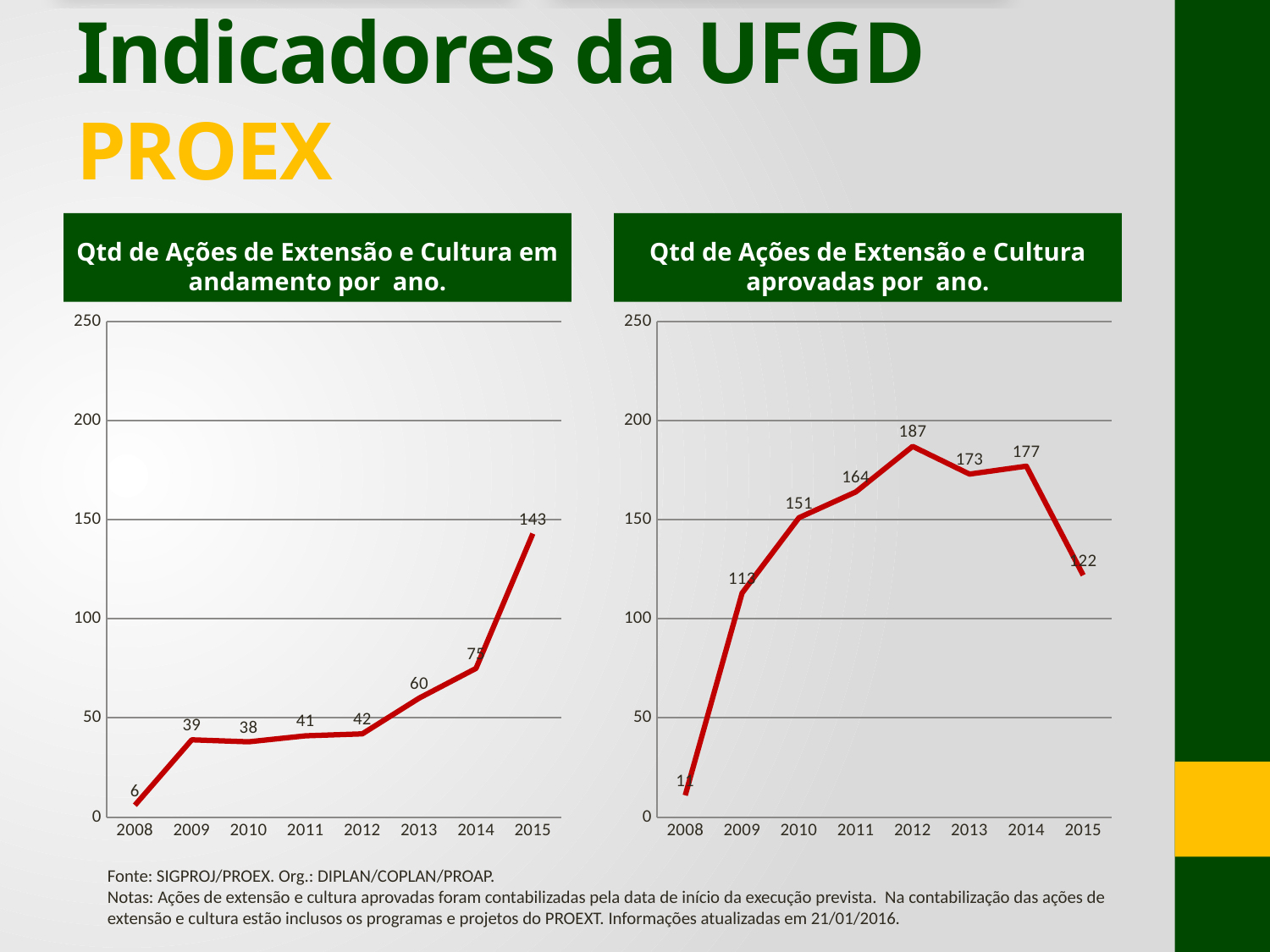
In the right chart (aprovadas por ano), does the value rise or fall from 2014 to 2015? Fall In the left chart (em andamento por ano), what is the value for 2013? 60 In the right chart (aprovadas por ano), is the value for 2009 greater or less than 100? greater In the left chart (em andamento por ano), what is the difference between the 2015 and 2014 values? 68 In the right chart (aprovadas por ano), which is larger, the value for 2013 or the value for 2014? 2014 What type of chart is used on this slide? Line chart In the right chart (aprovadas por ano), which year has the highest value? 2012 In the left chart (em andamento por ano), how many years are plotted? 8 In the left chart (em andamento por ano), which year has the lowest value? 2008 In the right chart (aprovadas por ano), what is the value for 2012? 187 In the left chart (em andamento por ano), what is the value for 2015? 143 In the right chart (aprovadas por ano), what is the difference between the 2014 and 2015 values? 55